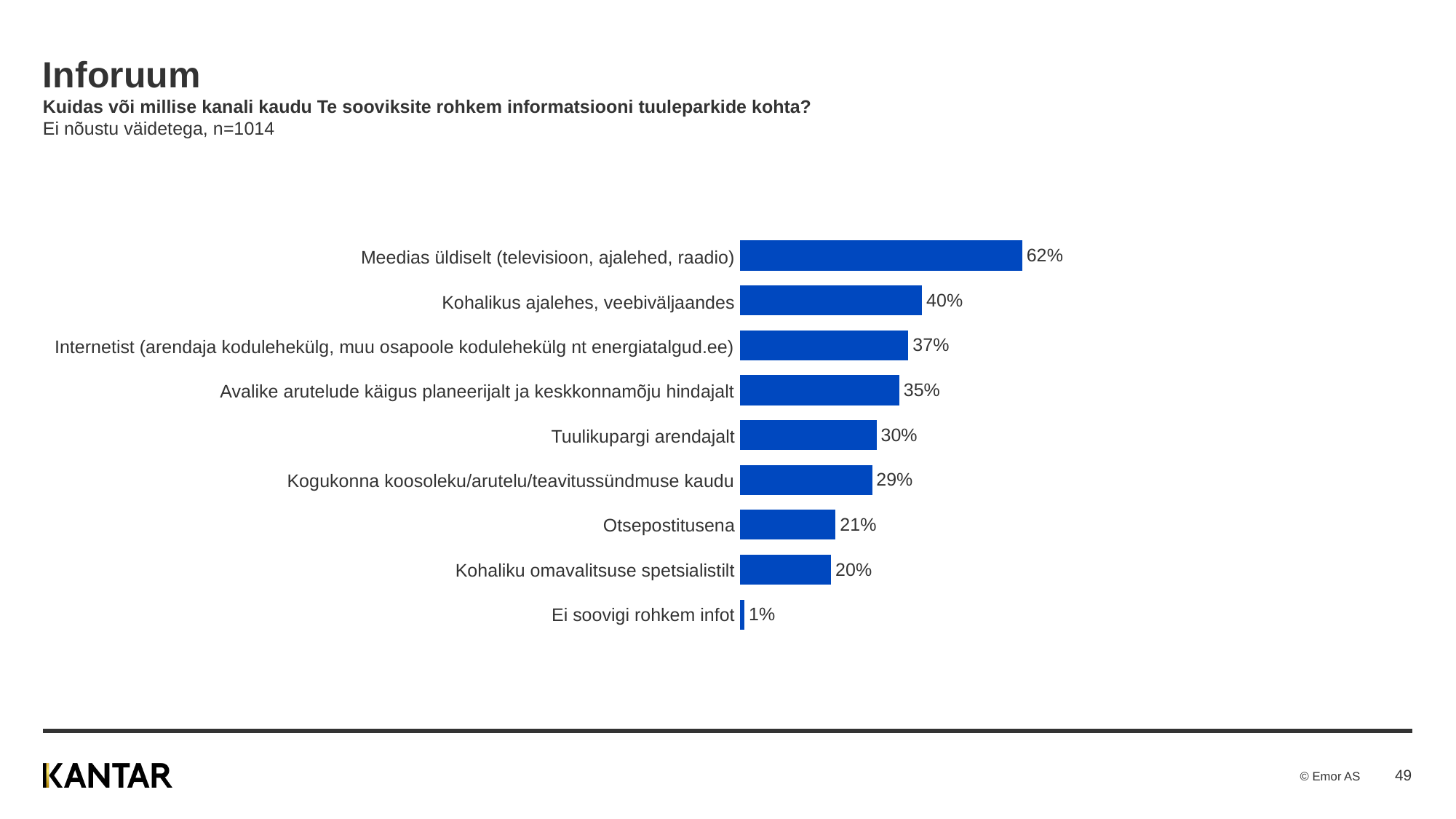
Which category has the highest value? Meedias üldiselt (televisioon, ajalehed, raadio) What is the value for "Kohaliku omavalitsuse spetsialistilt"? 20% How many categories are shown in the chart? 9 What is the value for "Kogukonna koosoleku/arutelu/teavitussündmuse kaudu"? 29% What is the difference between the values for "Meedias üldiselt (televisioon, ajalehed, raadio)" and "Kohalikus ajalehes, veebiväljaandes"? 22% Which category has the lowest value? Ei soovigi rohkem infot What is the value for "Meedias üldiselt (televisioon, ajalehed, raadio)"? 62% What kind of chart is shown on the slide? Bar chart What is the value for "Tuulikupargi arendajalt"? 30% What is the sample size (n) stated on the slide? n=1014 Which is larger: the value for "Internetist (arendaja kodulehekülg, muu osapoole kodulehekülg nt energiatalgud.ee)" or for "Avalike arutelude käigus planeerijalt ja keskkonnamõju hindajalt"? Internetist (arendaja kodulehekülg, muu osapoole kodulehekülg nt energiatalgud.ee) What is the difference between the values for "Kohalikus ajalehes, veebiväljaandes" and "Otsepostitusena"? 19%